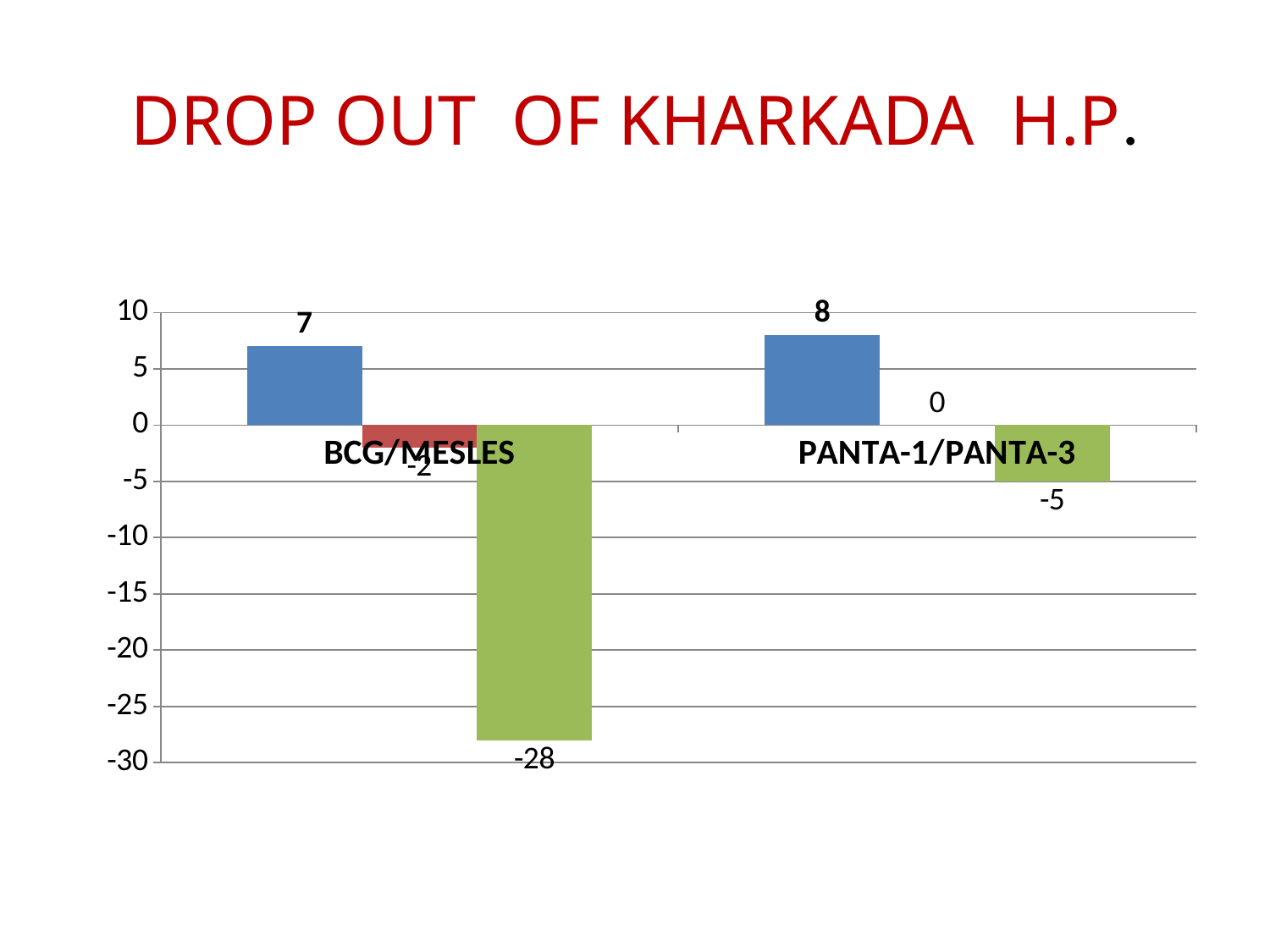
Which category has the higher blue bar, BCG/MESLES or PANTA-1/PANTA-3? PANTA-1/PANTA-3 What is the value of the green bar for BCG/MESLES? -28 What is the value of the blue bar for PANTA-1/PANTA-3? 8 What type of chart is shown on the slide? bar chart What is the value of the blue bar for BCG/MESLES? 7 Which data label shows the lowest value on the chart? -28 How many categories are shown on the x axis? 2 What is the value of the green bar for PANTA-1/PANTA-3? -5 What is the value of the red bar for BCG/MESLES? -2 What is the difference between the green bar values for BCG/MESLES and PANTA-1/PANTA-3? 23 What is the value of the middle (red) series for PANTA-1/PANTA-3? 0 What is the title of the slide? DROP OUT OF KHARKADA H.P.